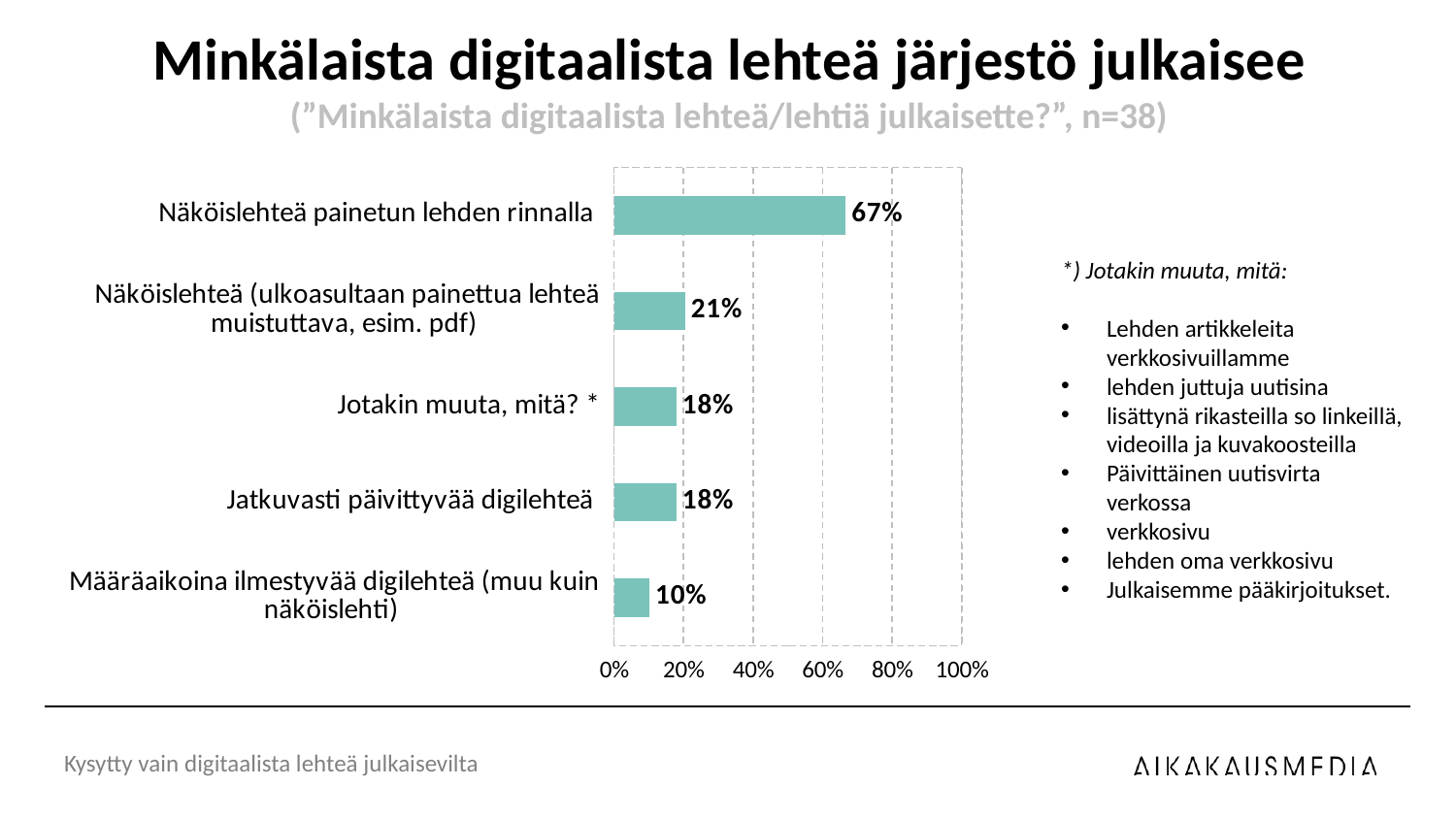
Is the value for "Näköislehteä painetun lehden rinnalla" greater or less than 60%? greater What is the value for "Jotakin muuta, mitä? *"? 18% What is the value for "Näköislehteä (ulkoasultaan painettua lehteä muistuttava, esim. pdf)"? 21% What is the difference between the values for "Näköislehteä painetun lehden rinnalla" and "Näköislehteä (ulkoasultaan painettua lehteä muistuttava, esim. pdf)"? 46% Which category has the highest value? Näköislehteä painetun lehden rinnalla What is the sample size (n) given in the chart subtitle? n=38 Which category has the lowest value? Määräaikoina ilmestyvää digilehteä (muu kuin näköislehti) What kind of chart is shown on the slide? bar chart Which is larger: the value for "Jatkuvasti päivittyvää digilehteä" or for "Määräaikoina ilmestyvää digilehteä (muu kuin näköislehti)"? Jatkuvasti päivittyvää digilehteä How many categories are shown in the chart? 5 What is the value for "Näköislehteä painetun lehden rinnalla"? 67% What is the value for "Määräaikoina ilmestyvää digilehteä (muu kuin näköislehti)"? 10%